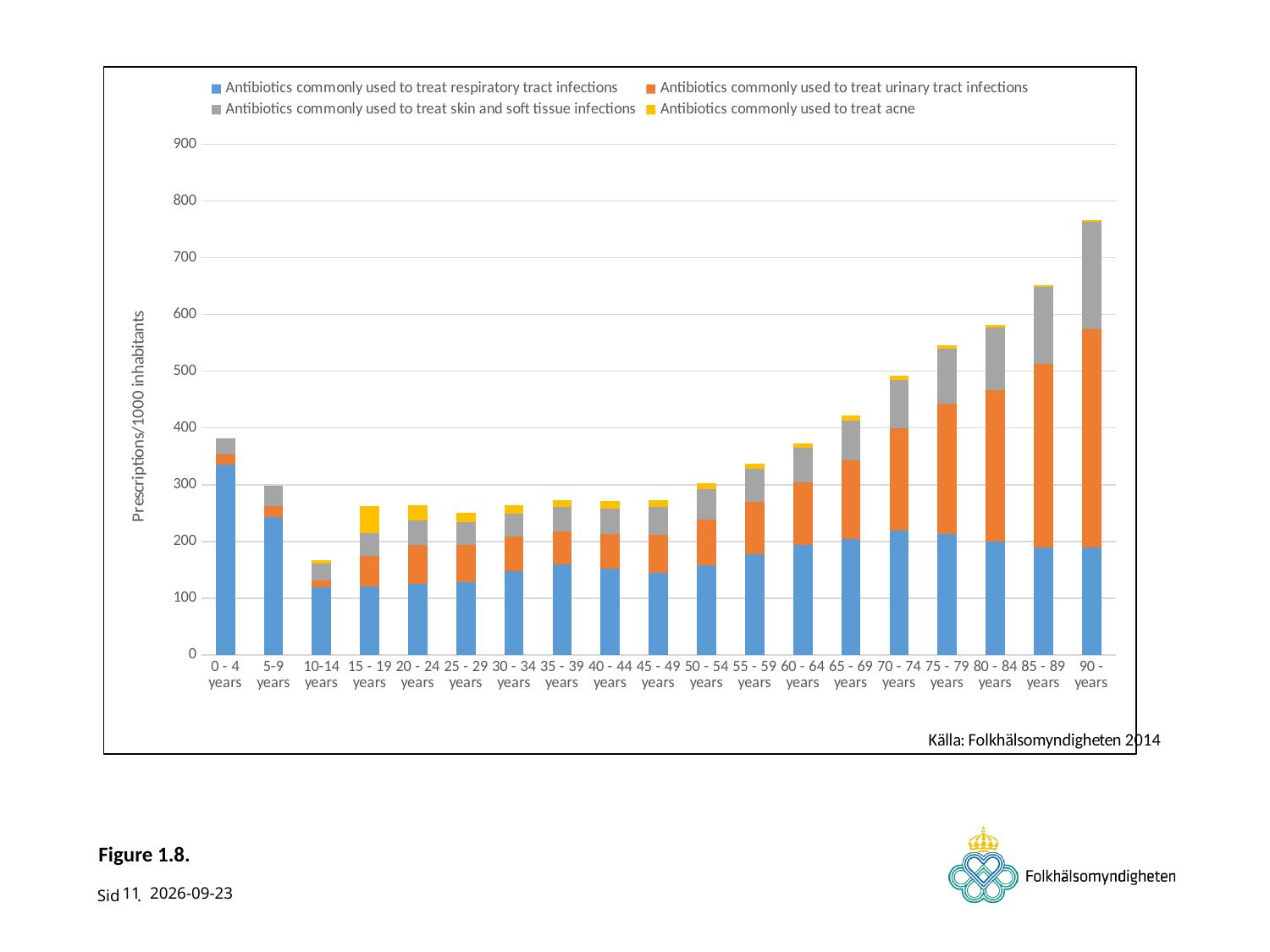
How many series does the chart's legend list? 4 What kind of chart is shown on the slide? stacked bar chart Which has a larger total bar, the 0 - 4 years group or the 5-9 years group? 0 - 4 years What is the label on the vertical axis of the chart? Prescriptions/1000 inhabitants Which age group has the lowest total prescriptions per 1000 inhabitants? 10-14 years How many age groups are shown on the x axis of the chart? 19 Is the total value for the 90 - years group greater or less than 700? greater Which colour represents antibiotics commonly used to treat acne in the chart? yellow Is the total value for the 0 - 4 years group greater or less than 300? greater Is the total value for the 10-14 years group greater or less than 200? less Do the total bar heights rise or fall from the 50 - 54 years group to the 90 - years group? rise Which age group has the highest total prescriptions per 1000 inhabitants? 90 - years